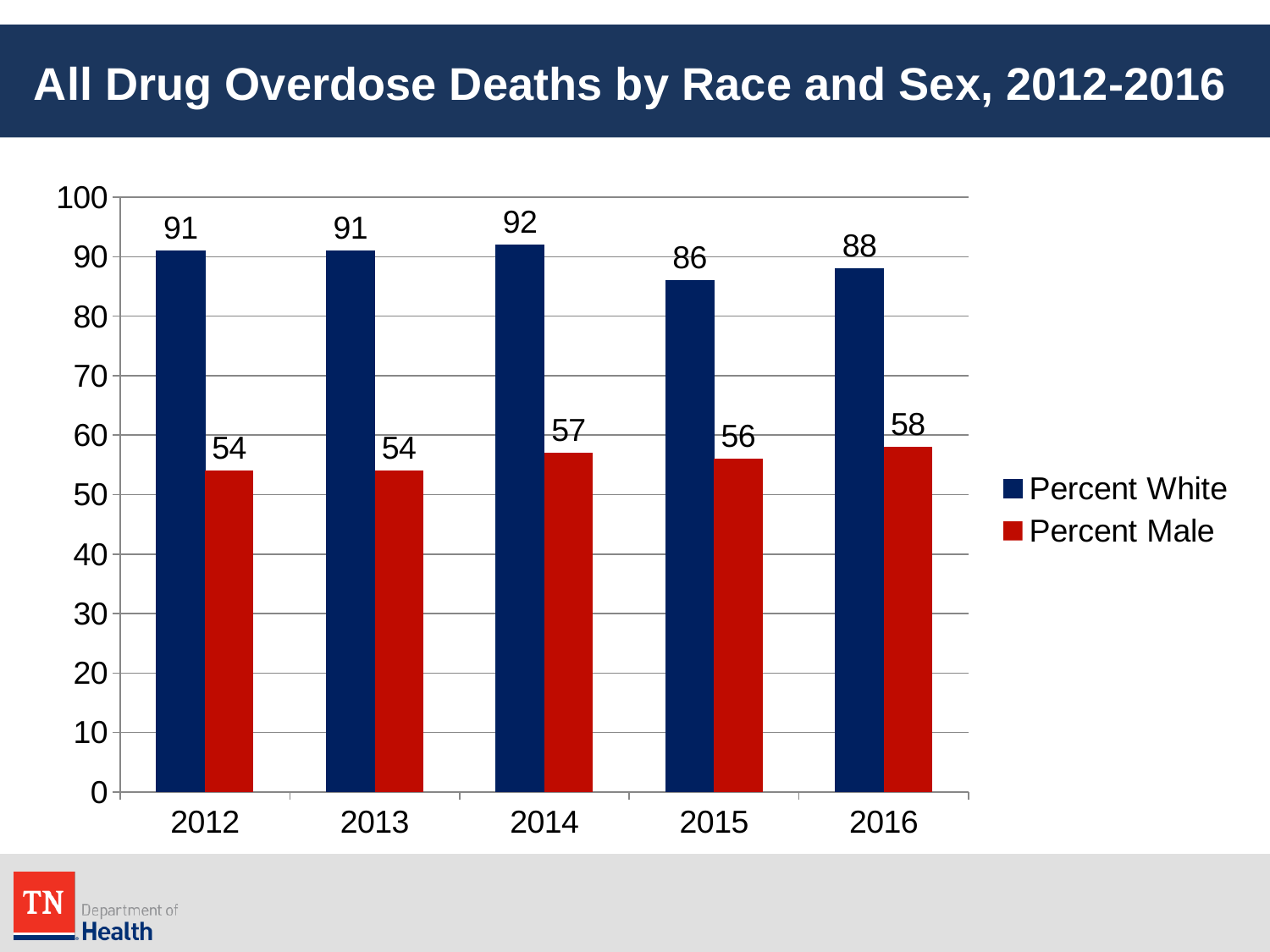
What is the difference between the Percent Male values for 2016 and 2013? 4 Which year has the lowest Percent White value? 2015 How many series does the legend list? 2 Which year has the highest Percent Male value? 2016 What is the difference between Percent White and Percent Male in 2012? 37 How many years are shown on the x axis? 5 What is the Percent White value for 2015? 86 Which is larger, the Percent White value for 2016 or for 2015? 2016 Which year has the highest Percent White value? 2014 What is the Percent Male value for 2016? 58 What is the Percent White value for 2014? 92 What kind of chart is shown on the slide? Bar chart